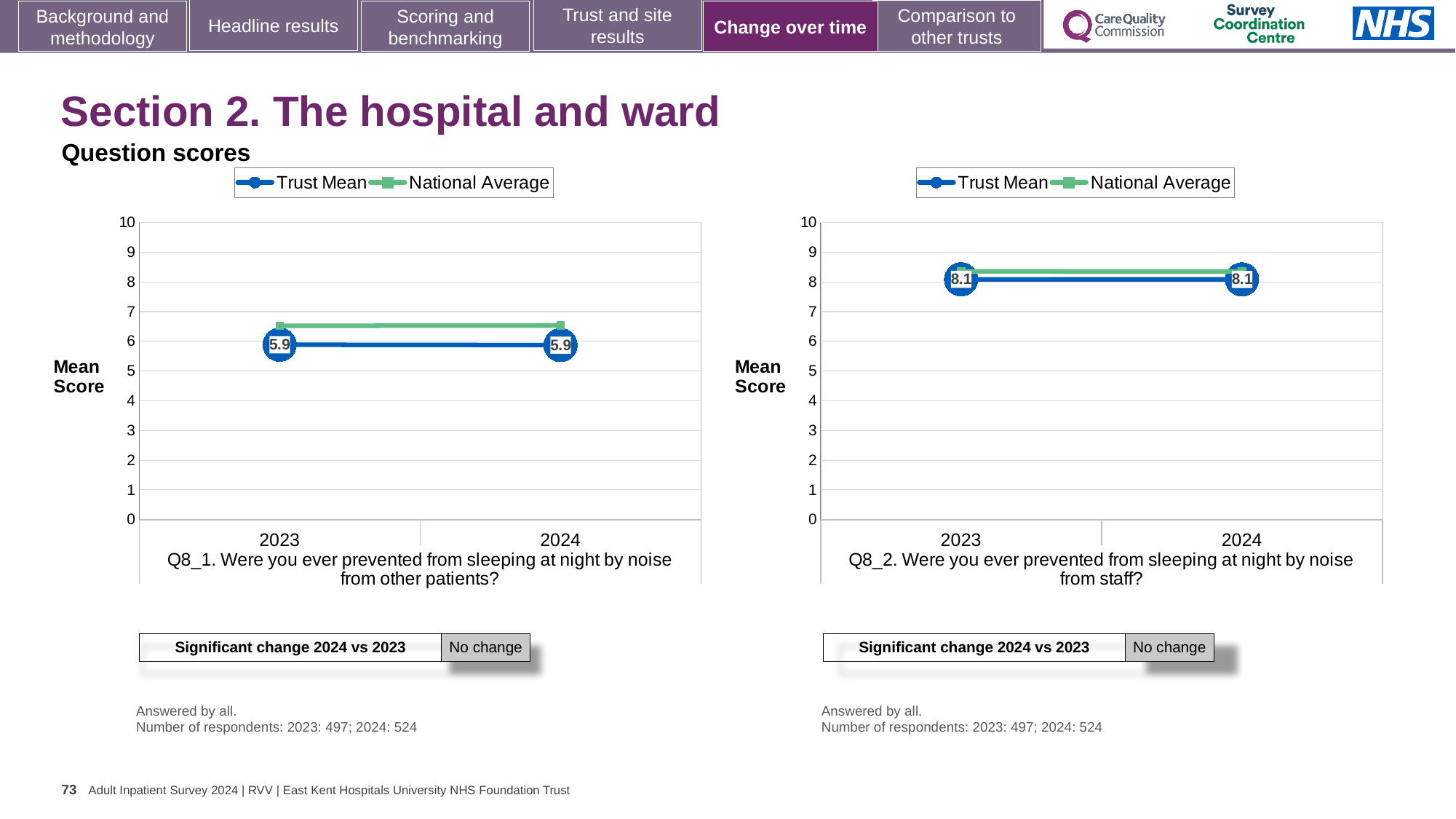
In the left chart (Q8_1), is the National Average for 2023 greater or less than 6? greater In the right chart (Q8_2), what is the Trust Mean score for 2024? 8.1 How many series does the legend of the right chart (Q8_2) list? 2 How many years are plotted on the x axis of the left chart (Q8_1)? 2 In the left chart (Q8_1), does the Trust Mean rise, fall or stay the same from 2023 to 2024? Stays the same In the right chart (Q8_2), what is the Trust Mean score for 2023? 8.1 In the left chart (Q8_1), what is the Trust Mean score for 2024? 5.9 In the left chart (Q8_1), what is the Trust Mean score for 2023? 5.9 In the left chart (Q8_1), which is higher in 2024, the Trust Mean or the National Average? National Average What does the 'Significant change 2024 vs 2023' box under the right chart (Q8_2) say? No change In the left chart (Q8_1), what is the difference between the Trust Mean for 2024 and 2023? 0 What kind of chart is the left chart (Q8_1)? Line chart